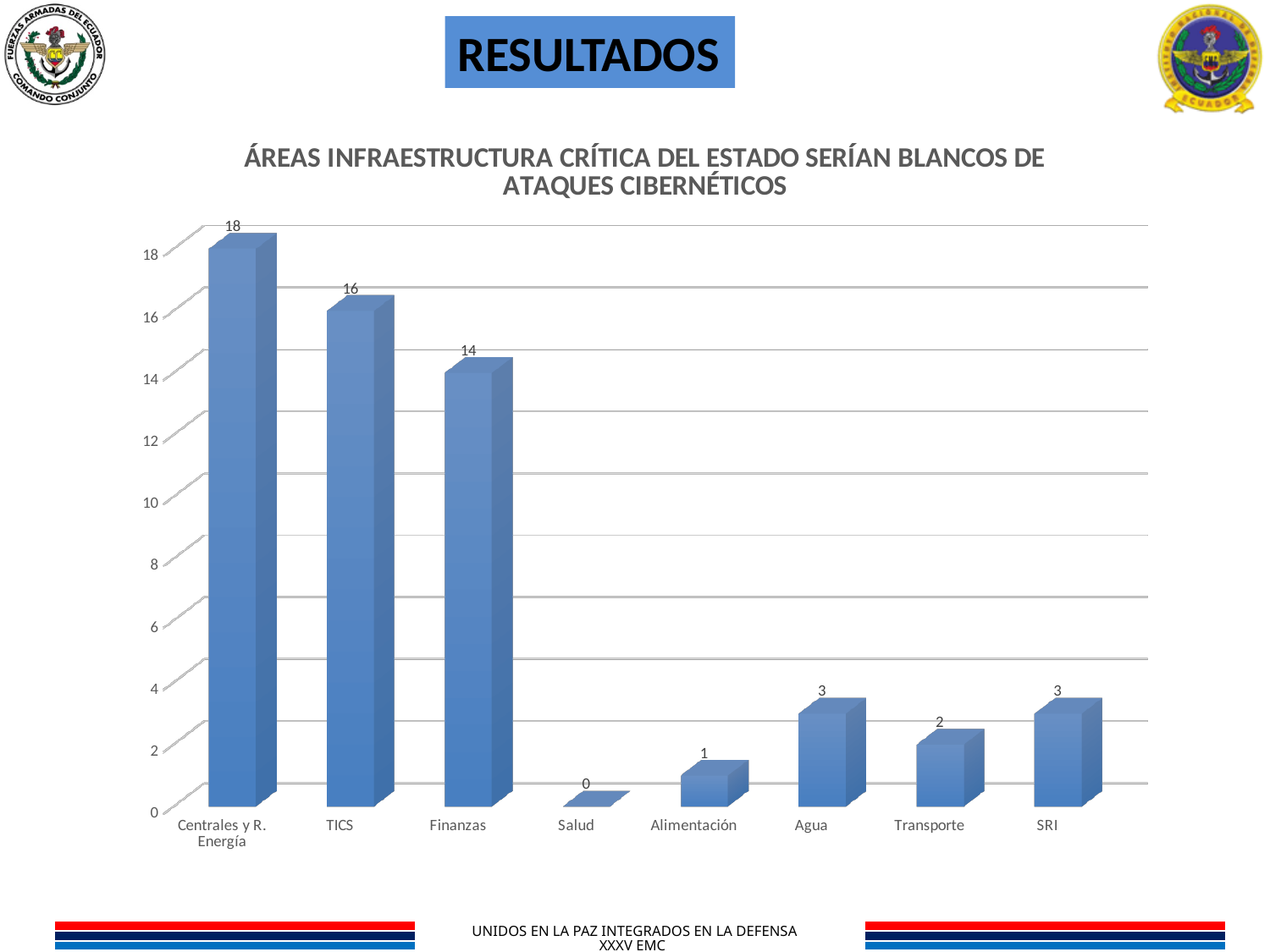
What is the title of the chart? ÁREAS INFRAESTRUCTURA CRÍTICA DEL ESTADO SERÍAN BLANCOS DE ATAQUES CIBERNÉTICOS What is the value for Salud? 0 What is the value for Finanzas? 14 Which is larger, the value for Agua or the value for Alimentación? Agua What kind of chart is shown on the slide? Bar chart Is the value for TICS greater or less than 10? greater How many categories are shown on the x axis? 8 Which category has the lowest value? Salud What is the value for TICS? 16 What is the value for Transporte? 2 Which category has the highest value? Centrales y R. Energía What is the difference between the values for Centrales y R. Energía and Finanzas? 4